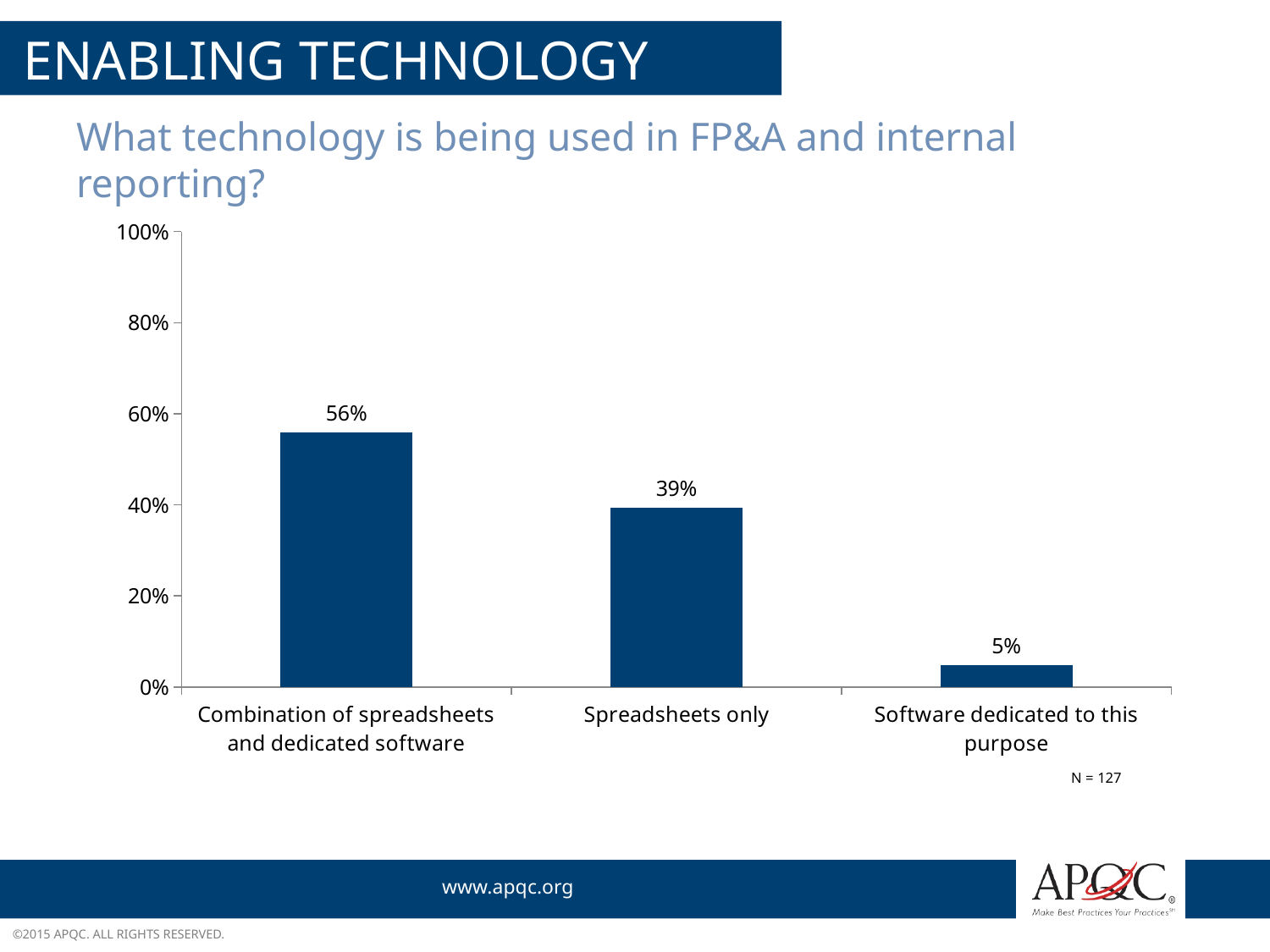
What percentage use software dedicated to this purpose? 5% What is the difference between the values for "Combination of spreadsheets and dedicated software" and "Spreadsheets only"? 17% Which category has the lowest value? Software dedicated to this purpose Which is larger, the value for "Spreadsheets only" or for "Software dedicated to this purpose"? Spreadsheets only What percentage of respondents use a combination of spreadsheets and dedicated software? 56% What is the sample size (N) noted below the chart? N = 127 What kind of chart is shown on the slide? Bar chart Is the value for "Combination of spreadsheets and dedicated software" greater or less than 60%? less How many categories are shown in the chart? 3 What is the value for "Spreadsheets only"? 39% Which category has the highest value? Combination of spreadsheets and dedicated software What is the difference between the values for "Spreadsheets only" and "Software dedicated to this purpose"? 34%